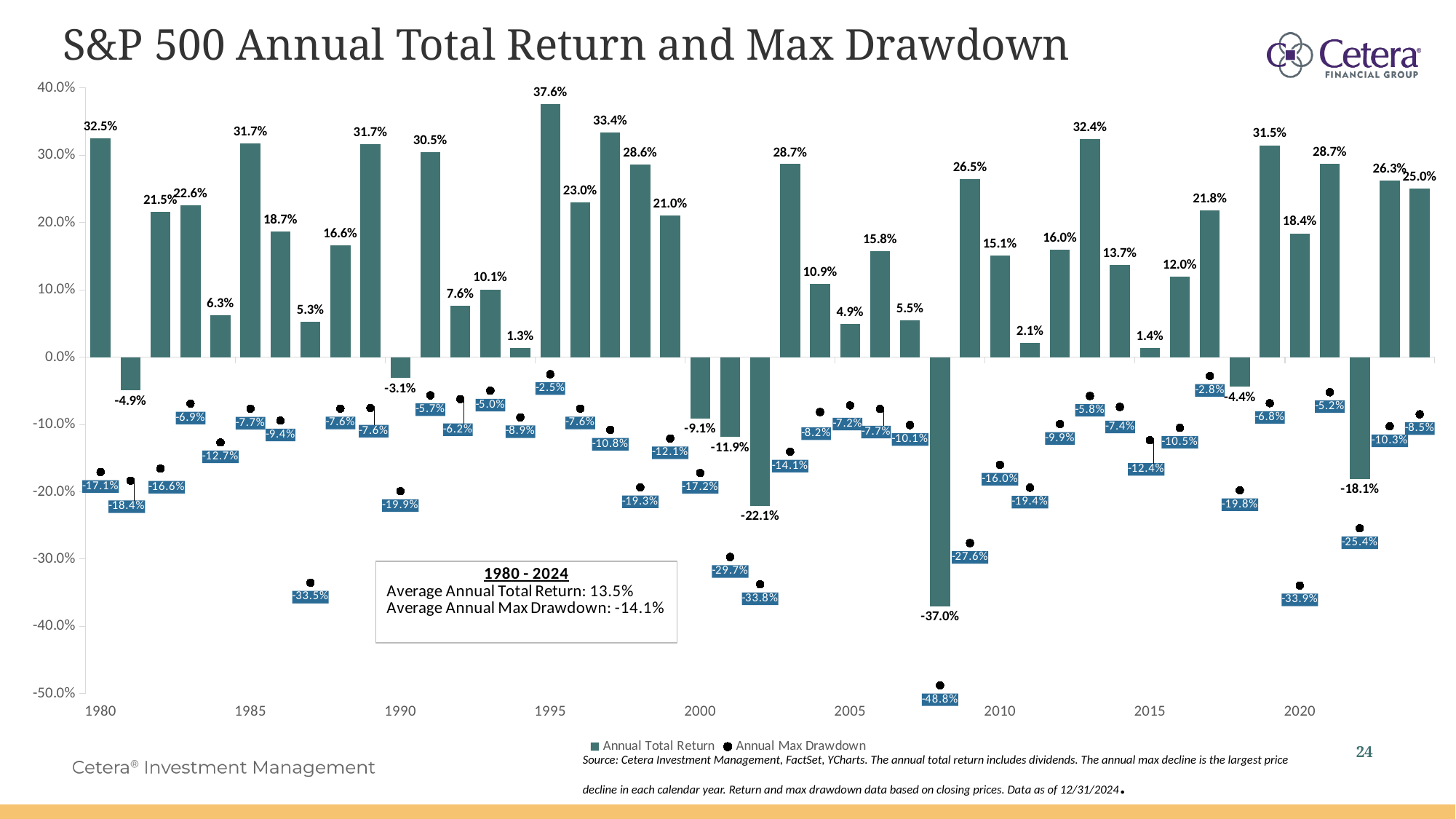
What is the difference between the annual total return in 1980 and in 1985? 0.8 percentage points What is the largest (most negative) annual max drawdown shown, and in which year? -48.8% in 2008 How many series does the legend list? 2 Which is larger, the annual total return for 2000 or for 2005? 2005 What is the annual total return shown for 2010? 15.1% What kind of chart is used to show the annual total return? Bar chart What is the annual max drawdown shown for 2020? -33.9% What is the annual total return shown for 1995? 37.6% According to the text box, what is the average annual total return for 1980 - 2024? 13.5% Which year has the lowest annual total return? 2008 Which year has the highest annual total return? 1995 According to the text box, what is the average annual max drawdown for 1980 - 2024? -14.1%